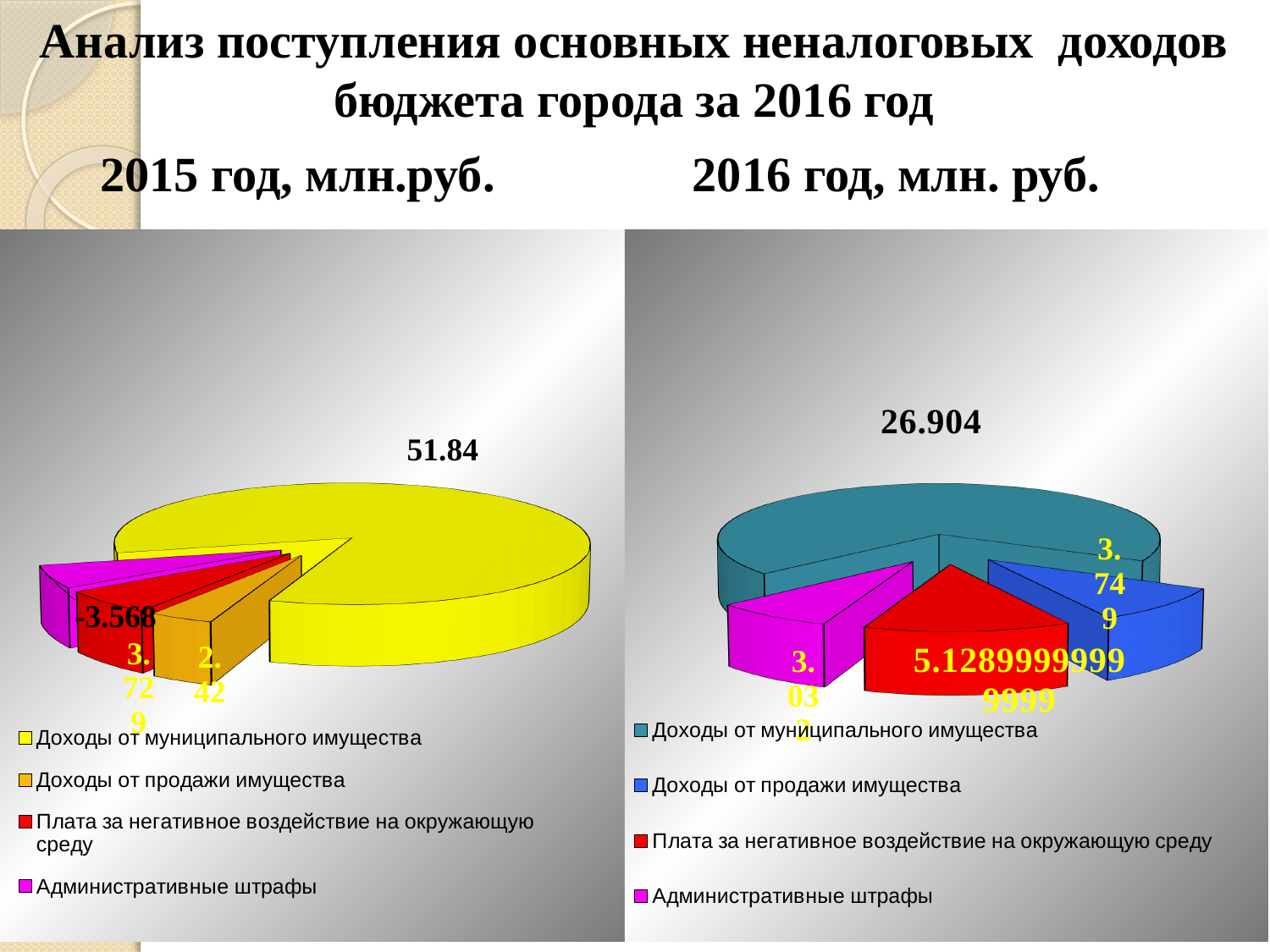
In the 2016 chart, what is the value for Доходы от продажи имущества? 3.749 By how much did Доходы от муниципального имущества fall from the 2015 chart to the 2016 chart? 24.936 In the 2015 chart, what is the value for Доходы от муниципального имущества? 51.84 Which year's chart shows the larger value for Доходы от муниципального имущества, 2015 or 2016? 2015 In the 2016 chart, what is the value for Административные штрафы? 3.032 How many categories does the legend of the 2016 chart list? 4 In the 2015 chart, what is the value for Доходы от продажи имущества? 2.42 In the 2016 chart, which category has the largest slice? Доходы от муниципального имущества In the 2016 chart, what is the value for Доходы от муниципального имущества? 26.904 What kind of chart is used for the 2015 data on the left? Pie chart In the 2016 chart, which is larger: Доходы от продажи имущества or Административные штрафы? Доходы от продажи имущества In the 2015 chart, which category has the largest slice? Доходы от муниципального имущества